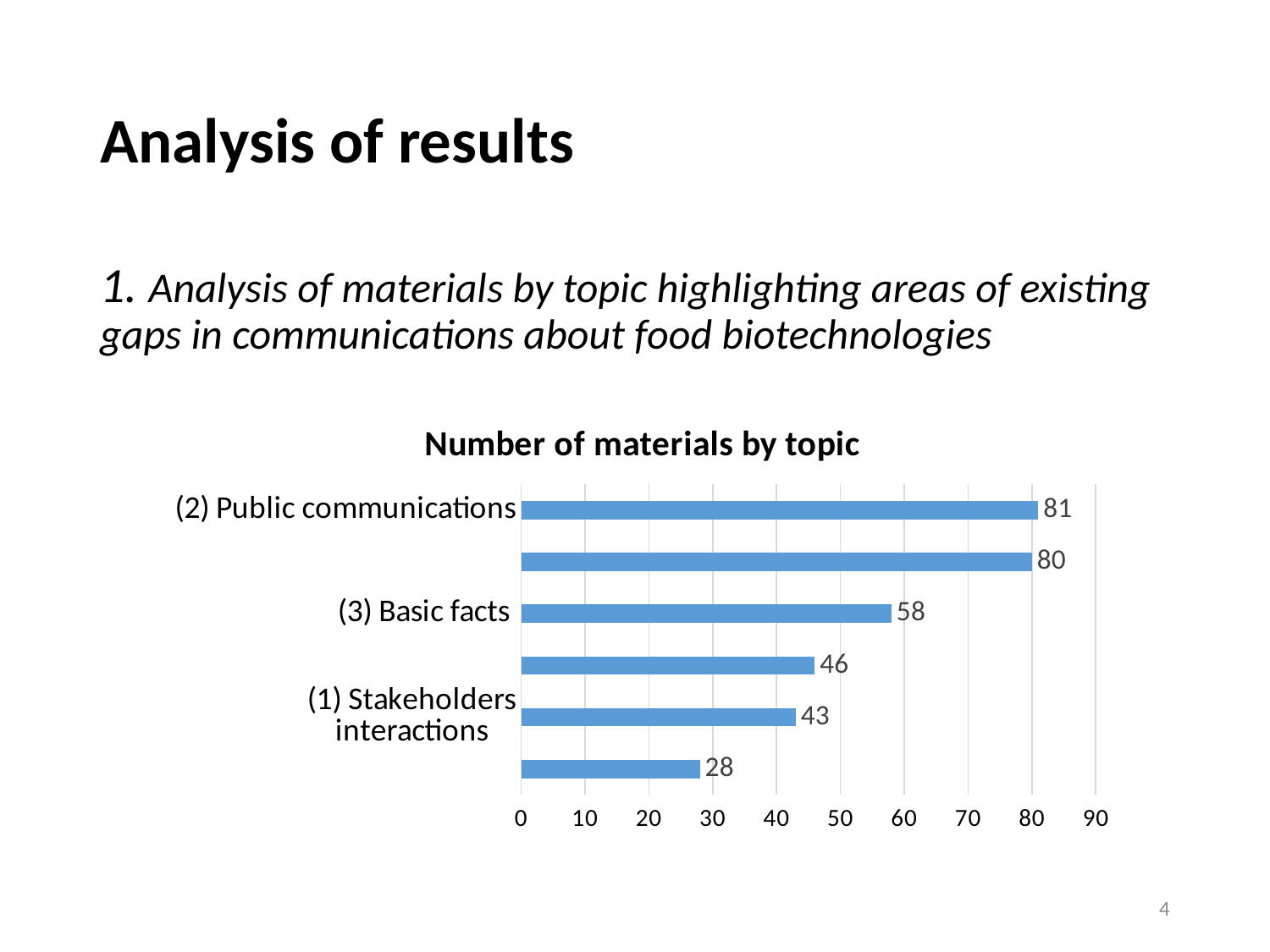
What is the smallest value shown on any bar in the chart? 28 What is the value for (1) Stakeholders interactions? 43 Which labelled topic has the lowest number of materials? (1) Stakeholders interactions What is the difference between the values for (3) Basic facts and (1) Stakeholders interactions? 15 What is the value for (2) Public communications in the Number of materials by topic chart? 81 How many bars are plotted in the chart? 6 What kind of chart is shown on the slide? Bar chart What is the largest value shown on any bar in the chart? 81 Which is larger, the value for (3) Basic facts or the value for (1) Stakeholders interactions? (3) Basic facts What is the difference between the values for (2) Public communications and (3) Basic facts? 23 What is the value for (3) Basic facts? 58 Which labelled topic has the highest number of materials? (2) Public communications